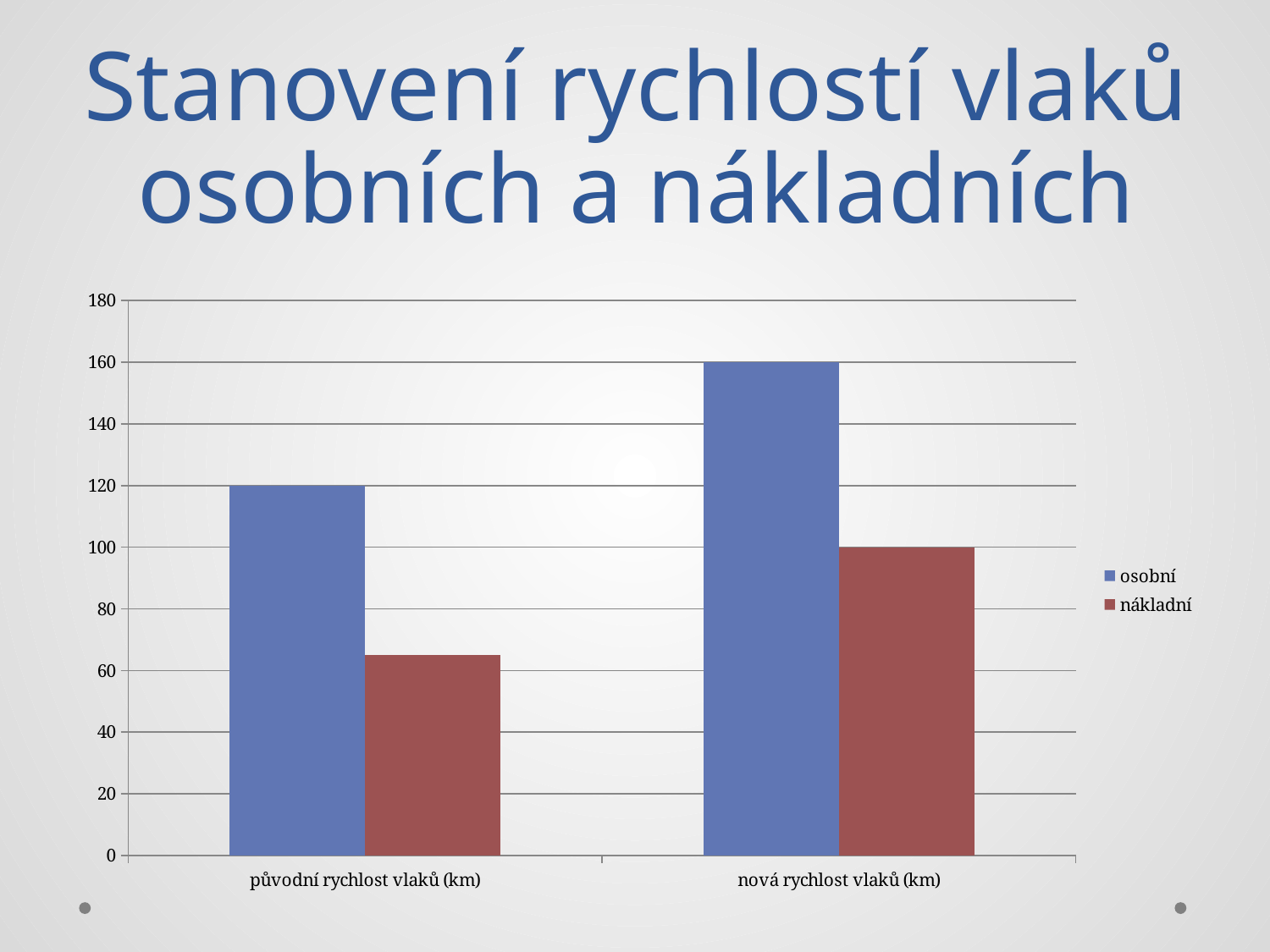
How many series does the legend list? 2 What kind of chart is shown on the slide? bar chart Which bar is the lowest in the chart? nákladní, původní rychlost vlaků (km) Is the value for nákladní in the category původní rychlost vlaků (km) greater or less than 80? less Is the value for nákladní in the category původní rychlost vlaků (km) greater or less than 60? greater What is the value for osobní in the category nová rychlost vlaků (km)? 160 Which series has the higher value in the category nová rychlost vlaků (km)? osobní How many categories are shown on the x axis? 2 What is the value for osobní in the category původní rychlost vlaků (km)? 120 What is the difference between the osobní values for nová rychlost vlaků (km) and původní rychlost vlaků (km)? 40 What is the value for nákladní in the category nová rychlost vlaků (km)? 100 Which series is shown in red? nákladní